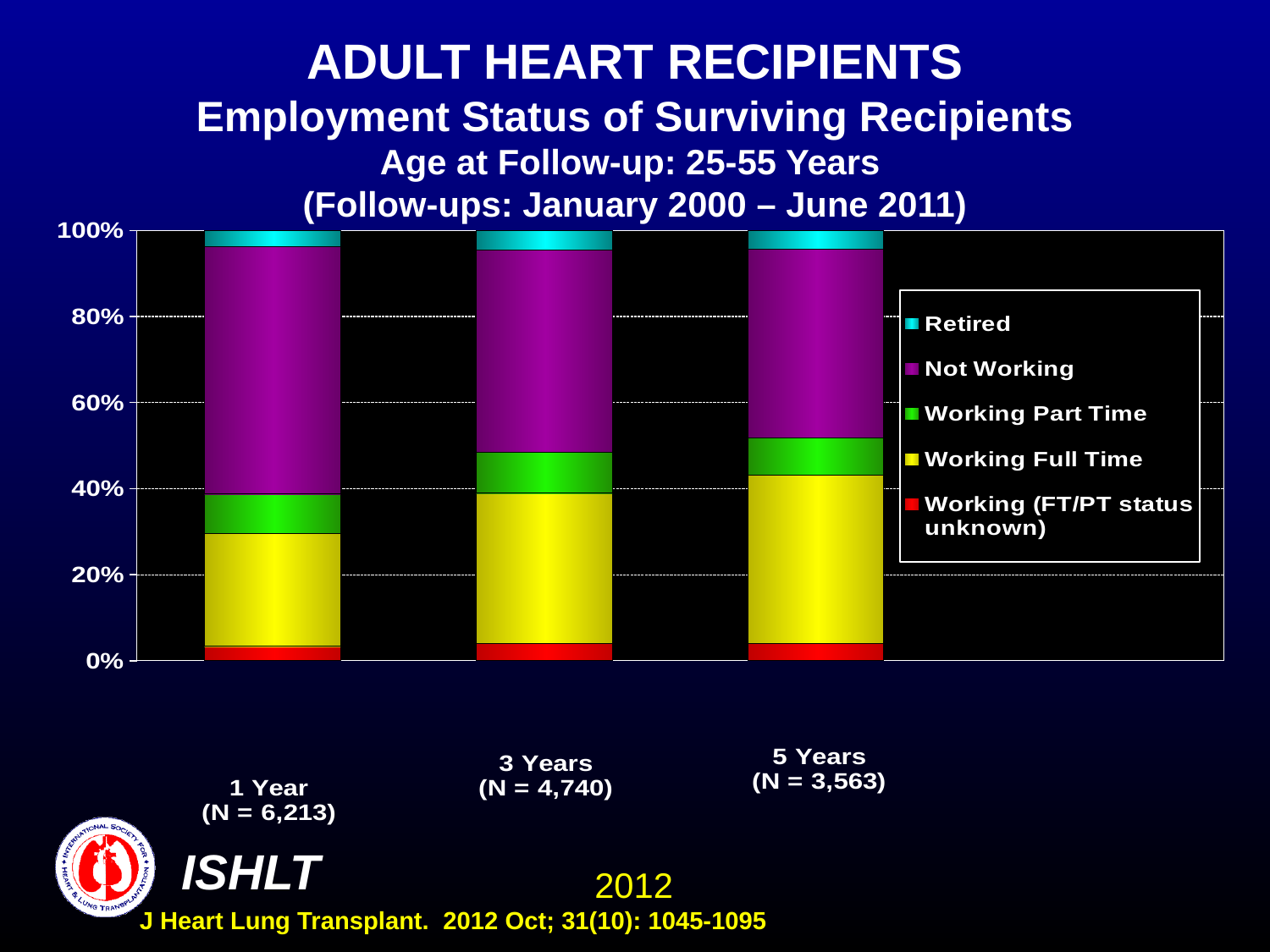
Which has the larger Working Full Time share, 1 Year or 5 Years? 5 Years What is the N shown for the 1 Year category? N = 6,213 Is the Retired share for 5 Years greater or less than 20%? less Does the Working Full Time share rise or fall from 1 Year to 5 Years? rise Is the Not Working share for 1 Year greater or less than 40%? greater Is the Working Full Time share for 1 Year greater or less than 20%? greater What kind of chart is shown on the slide? Stacked bar chart How many follow-up time points (categories) are plotted on the chart? 3 Which has the larger Not Working share, 1 Year or 5 Years? 1 Year What is the N shown for the 3 Years category? N = 4,740 How many series does the legend list? 5